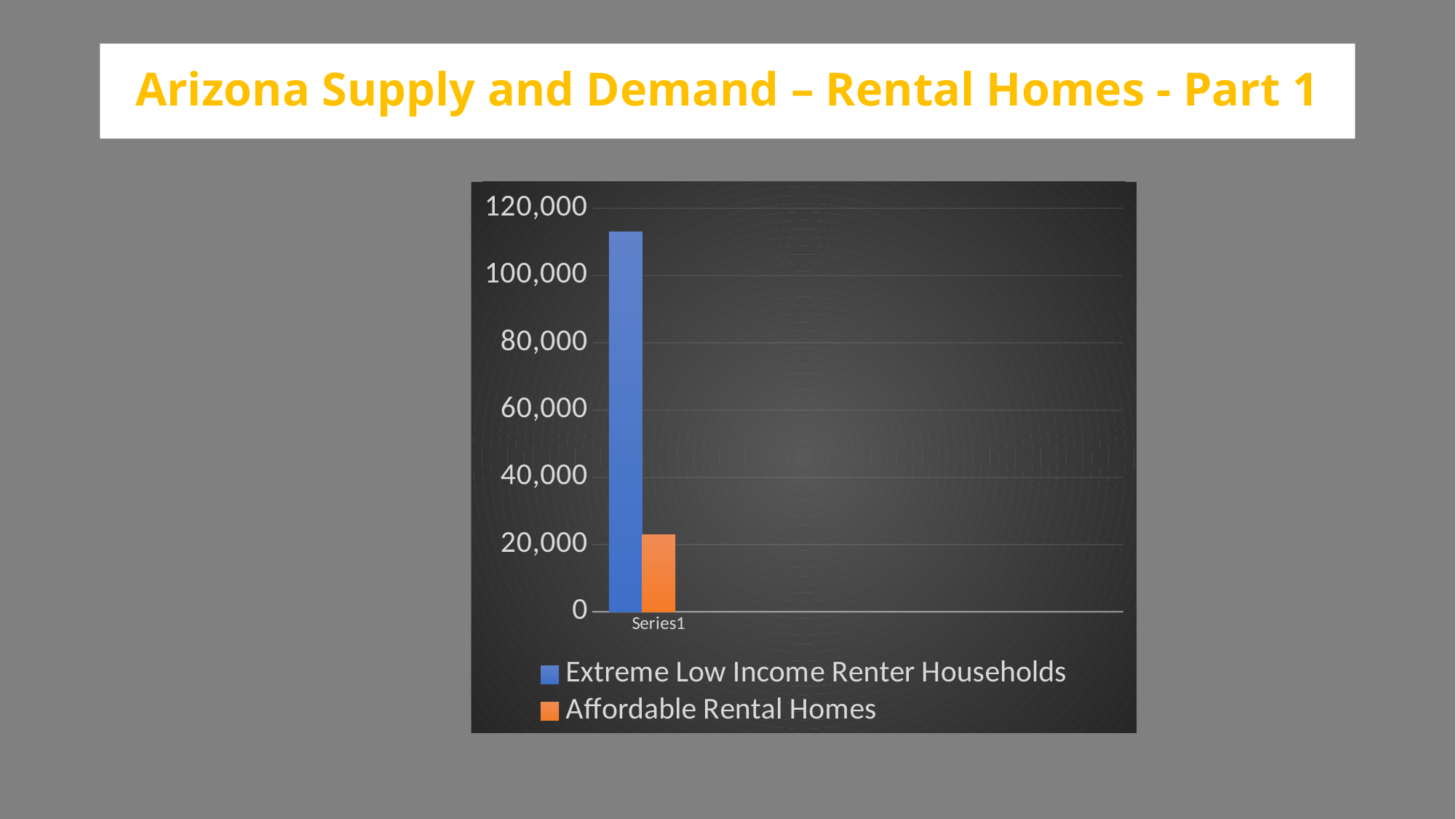
Which series has the highest value? Extreme Low Income Renter Households How many series does the legend list? 2 Is the value for Extreme Low Income Renter Households greater or less than 100,000? greater Which series has the lowest value? Affordable Rental Homes Is the value for Extreme Low Income Renter Households greater or less than 120,000? less What is the title of the slide? Arizona Supply and Demand – Rental Homes - Part 1 Is the value for Affordable Rental Homes greater or less than 40,000? less How many categories are shown on the x axis? 1 What is the label of the category on the x axis? Series1 What colour is the bar for Affordable Rental Homes? orange Which series has the higher value: Extreme Low Income Renter Households or Affordable Rental Homes? Extreme Low Income Renter Households What kind of chart is shown on the slide? bar chart